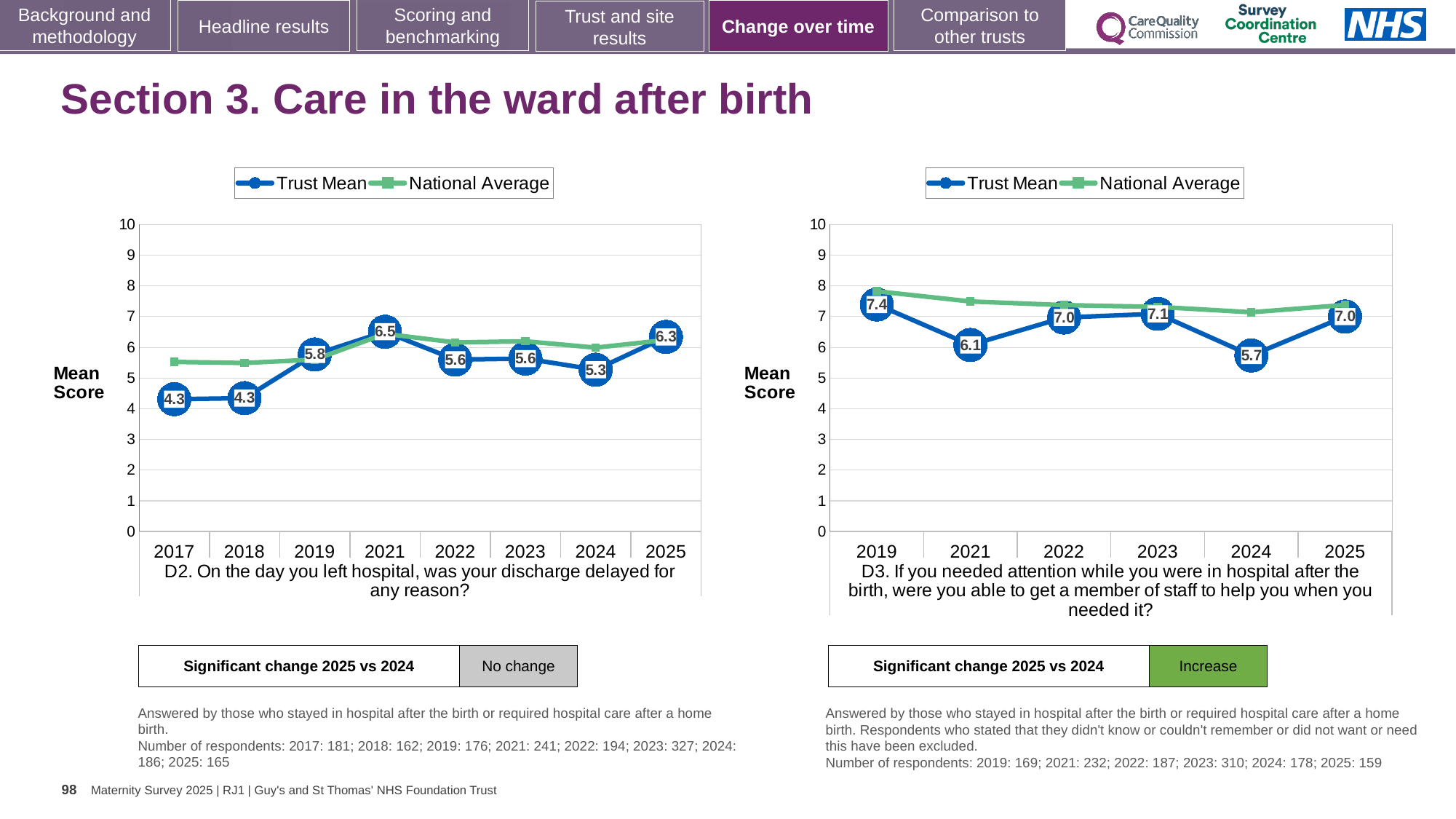
What kind of chart is the D2 chart (left)? Line chart On the D3 chart (right), which year has the highest Trust Mean score? 2019 On the D2 chart (left), what is the difference between the Trust Mean scores for 2025 and 2024? 1.0 On the D2 chart (left), does the Trust Mean rise or fall from 2018 to 2019? Rise On the D3 chart (right), which year has the lowest Trust Mean score? 2024 On the D3 chart (right), which is larger, the Trust Mean for 2019 or for 2021? 2019 On the D2 chart (left), what is the Trust Mean score for 2021? 6.5 On the D2 chart (left), what is the Trust Mean score for 2017? 4.3 How many years are plotted on the D2 chart (left)? 8 On the D2 chart (left), is the National Average for 2017 greater or less than 5? greater How many series does the legend of the D3 chart (right) list? 2 On the D3 chart (right), what is the Trust Mean score for 2024? 5.7